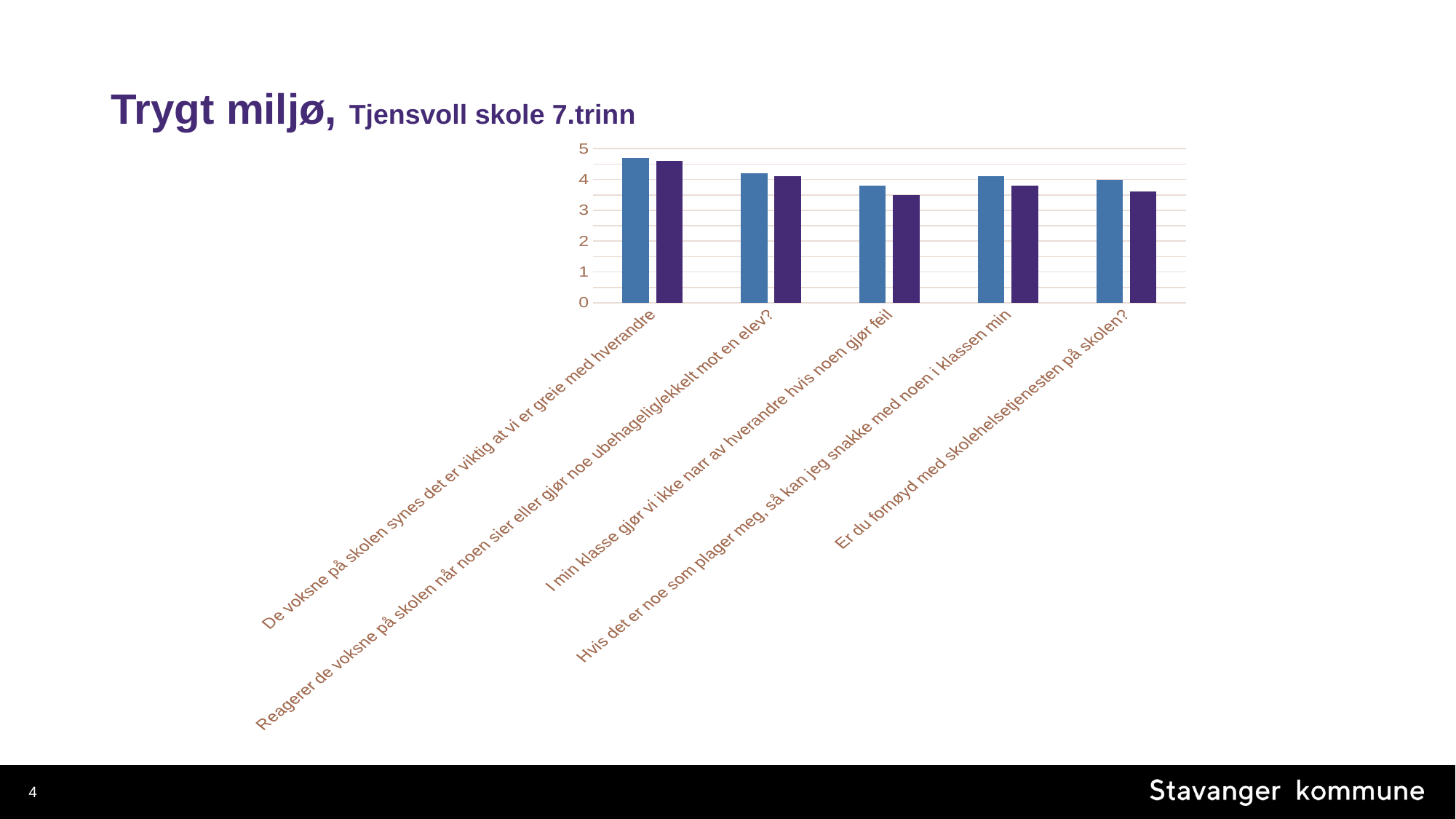
What kind of chart is shown on the slide? bar chart Is the blue bar for "Reagerer de voksne på skolen når noen sier eller gjør noe ubehagelig/ekkelt mot en elev?" greater or less than 4? greater Which category has the highest blue bar? De voksne på skolen synes det er viktig at vi er greie med hverandre Is the purple bar for "I min klasse gjør vi ikke narr av hverandre hvis noen gjør feil" greater or less than 4? less Is the purple bar for "Er du fornøyd med skolehelsetjenesten på skolen?" greater or less than 4? less For "I min klasse gjør vi ikke narr av hverandre hvis noen gjør feil", which bar is taller, the blue or the purple one? blue For "Hvis det er noe som plager meg, så kan jeg snakke med noen i klassen min", which bar is taller, the blue or the purple one? blue How many categories (questions) are shown on the x axis of the chart? 5 What two colours are used for the bars in the chart? blue and purple How many bars are plotted in the chart in total? 10 What is the title of the slide containing the chart? Trygt miljø, Tjensvoll skole 7.trinn